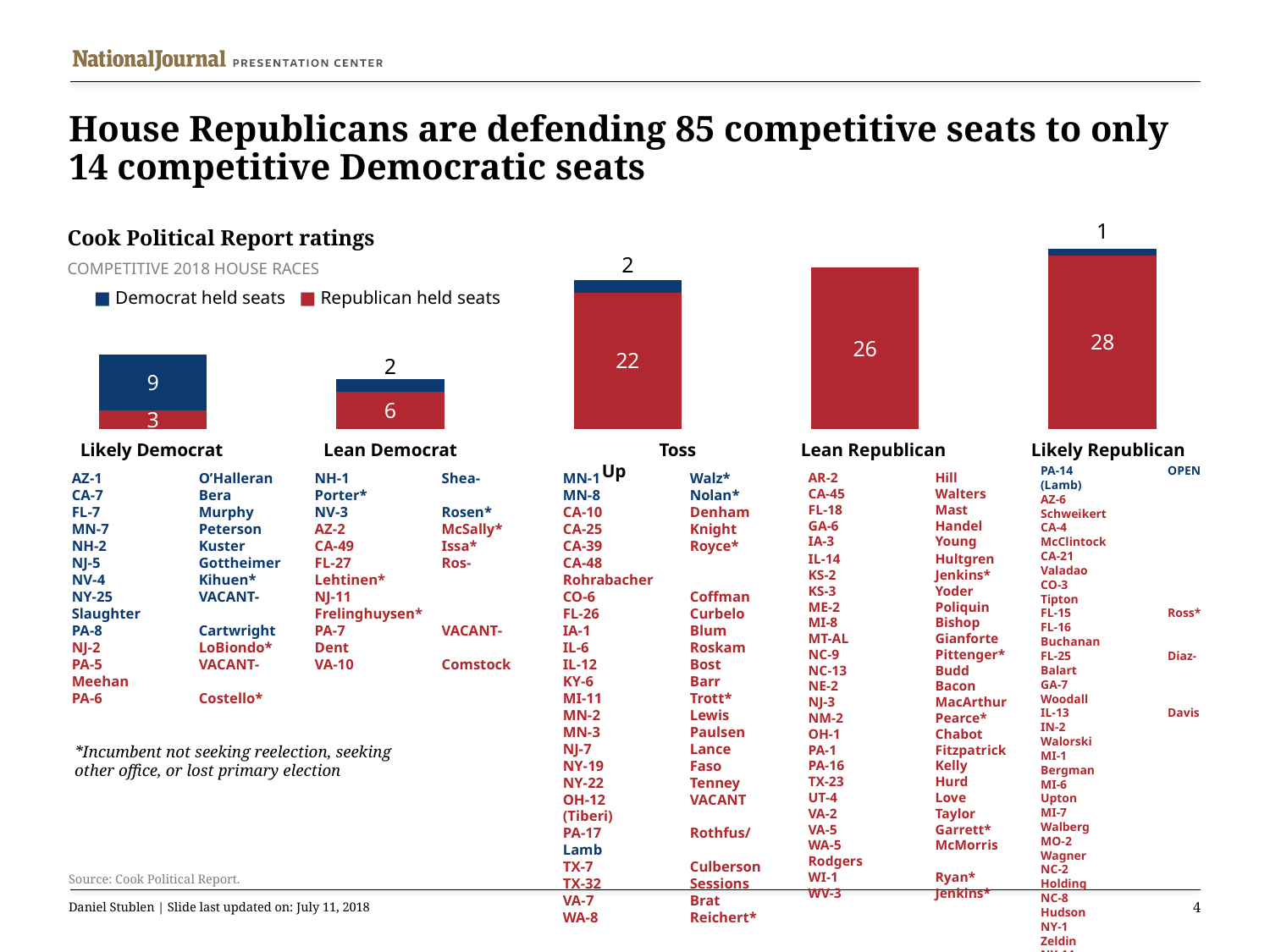
How many Republican held seats are in the Toss Up category? 22 How many Democrat held seats are in the Likely Republican category? 1 What is the difference between Republican held seats in Likely Republican and Toss Up? 6 What kind of chart is shown on the slide? stacked bar chart Which colour represents Democrat held seats in the chart? blue How many series does the chart legend list? 2 How many Democrat held seats are in the Likely Democrat category? 9 Which category has the highest number of Republican held seats? Likely Republican What is the total number of seats in the Lean Democrat bar? 8 How many Republican held seats are in the Lean Republican category? 26 Which category has the lowest number of Republican held seats? Likely Democrat How many rating categories are shown along the x axis of the chart? 5